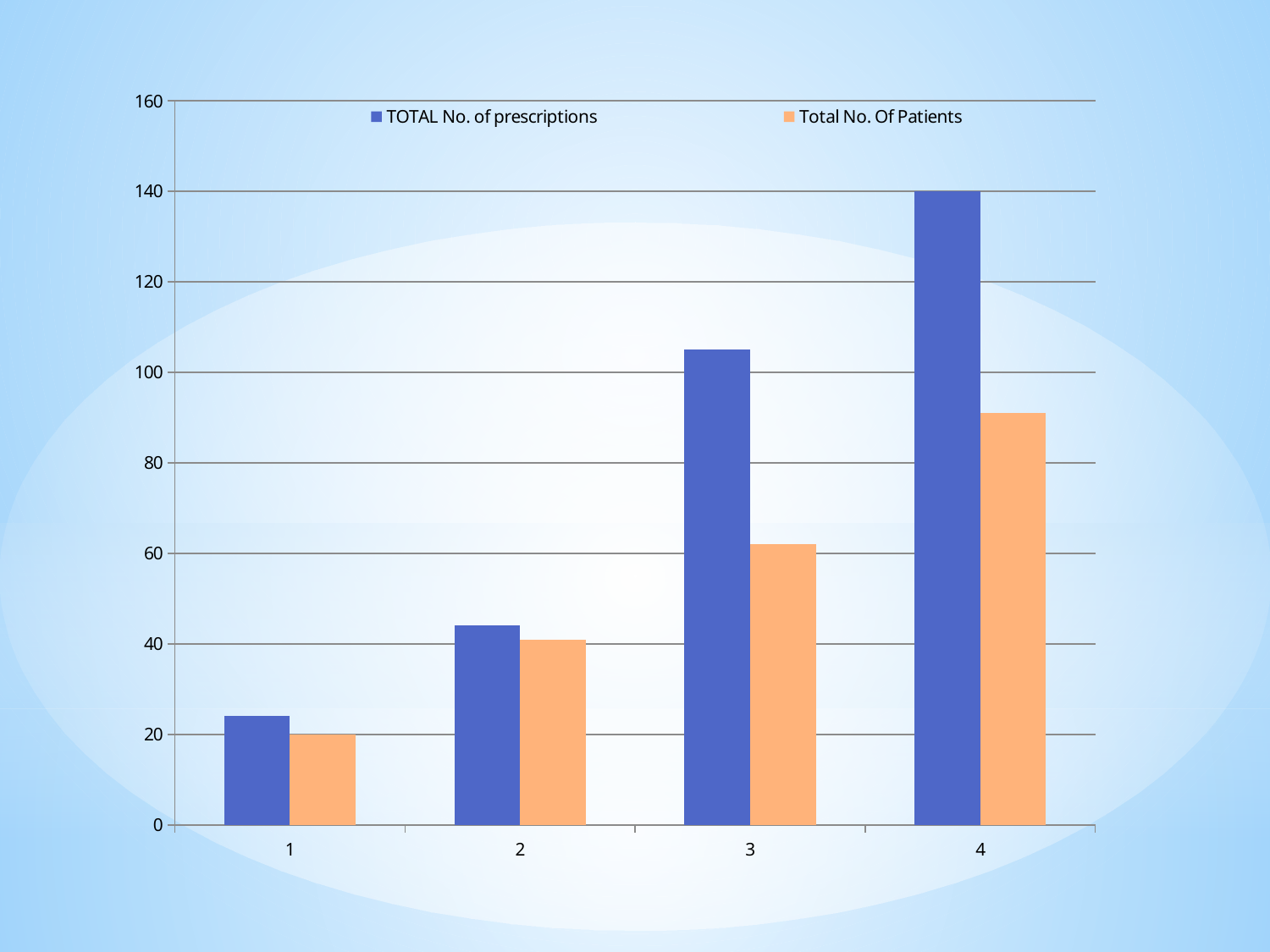
How many categories are shown on the x axis? 4 What is the value for TOTAL No. of prescriptions in category 4? 140 How many series does the legend list? 2 In category 3, which is larger: TOTAL No. of prescriptions or Total No. Of Patients? TOTAL No. of prescriptions What kind of chart is shown on the slide? bar chart Which category has the lowest value for Total No. Of Patients? 1 What is the value for Total No. Of Patients in category 1? 20 Is the value for Total No. Of Patients in category 4 greater or less than 100? less Do the values for TOTAL No. of prescriptions rise or fall from category 1 to category 4? rise Is the value for TOTAL No. of prescriptions in category 3 greater or less than 100? greater Which category has the highest value for TOTAL No. of prescriptions? 4